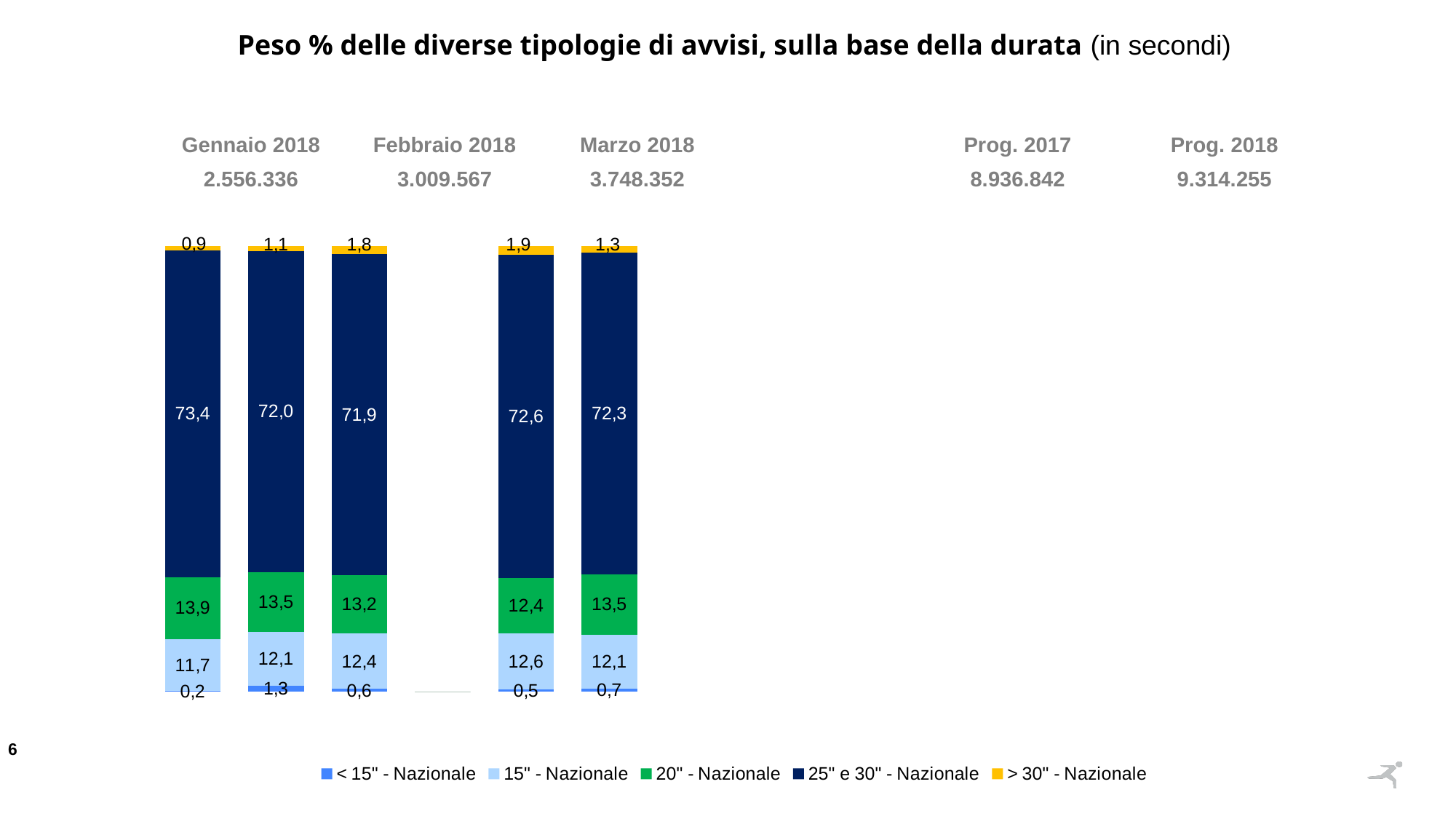
What is the difference between the 15" - Nazionale values for Prog. 2017 and Prog. 2018? 0,5 Which period has the lowest value for the < 15" - Nazionale segment? Gennaio 2018 Which is larger, the 20" - Nazionale value for Gennaio 2018 or for Prog. 2017? Gennaio 2018 How many series does the legend list? 5 What is the value of the 25" e 30" - Nazionale segment for Gennaio 2018? 73,4 What total is shown above the Marzo 2018 column? 3.748.352 What is the title of the chart? Peso % delle diverse tipologie di avvisi, sulla base della durata (in secondi) Which period has the highest value for the 25" e 30" - Nazionale segment? Gennaio 2018 What is the value of the > 30" - Nazionale segment for Prog. 2017? 1,9 What is the value of the 20" - Nazionale segment for Marzo 2018? 13,2 What is the value of the < 15" - Nazionale segment for Febbraio 2018? 1,3 What type of chart is shown on the slide? stacked bar chart